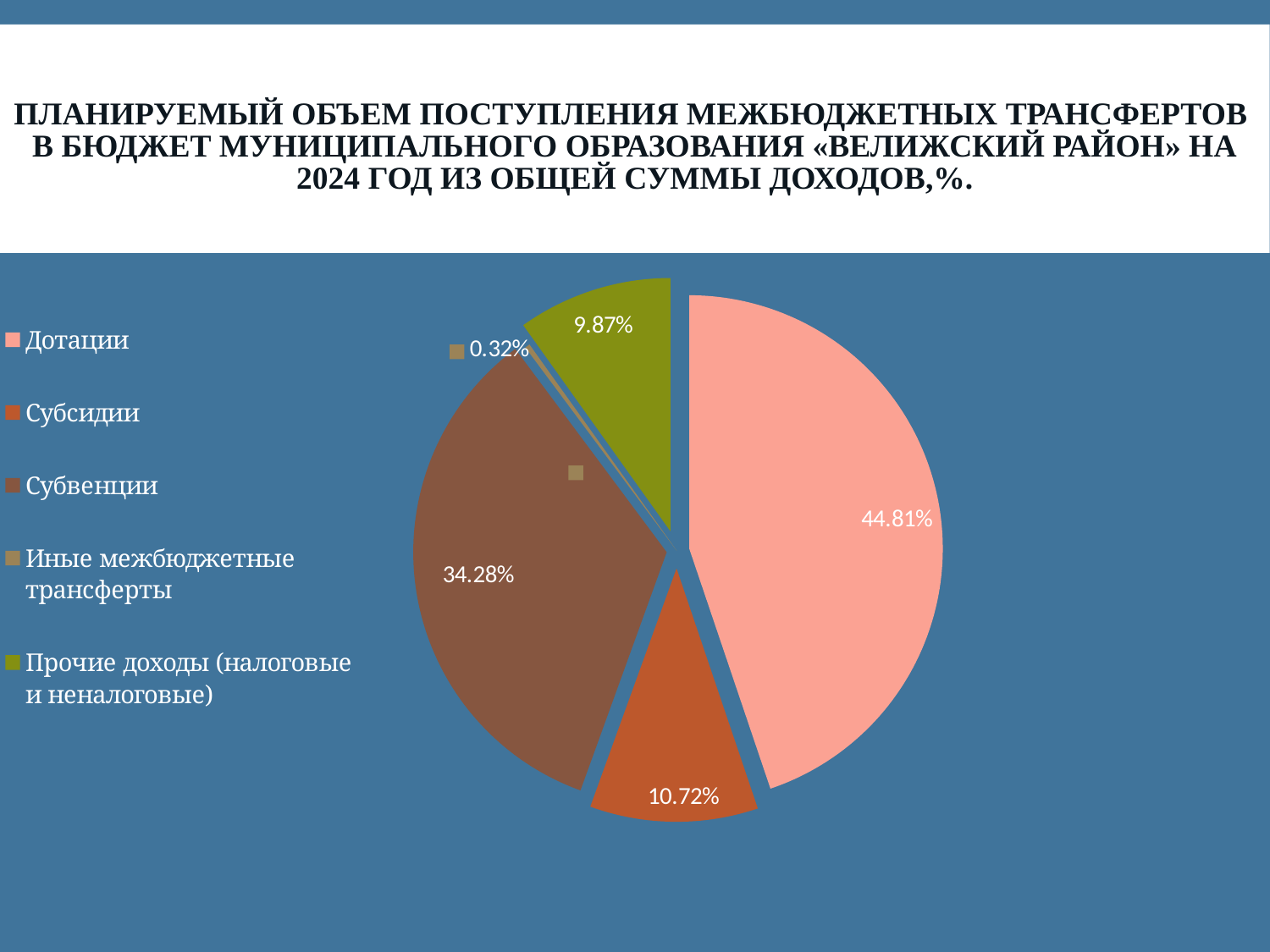
What is the difference between the shares of Дотации and Субвенции? 10.53% What share is shown for Прочие доходы (налоговые и неналоговые)? 9.87% Which category has the largest slice of the pie? Дотации What is the value shown for Субвенции? 34.28% What is the value for Иные межбюджетные трансферты? 0.32% Which category has the smallest slice of the pie? Иные межбюджетные трансферты What percentage is shown for Субсидии? 10.72% What type of chart is shown on the slide? Pie chart Which is larger, the share of Субсидии or the share of Прочие доходы (налоговые и неналоговые)? Субсидии What share of the pie does Дотации account for? 44.81% How many categories does the pie chart show? 5 What colour is the slice for Прочие доходы (налоговые и неналоговые)? Olive green